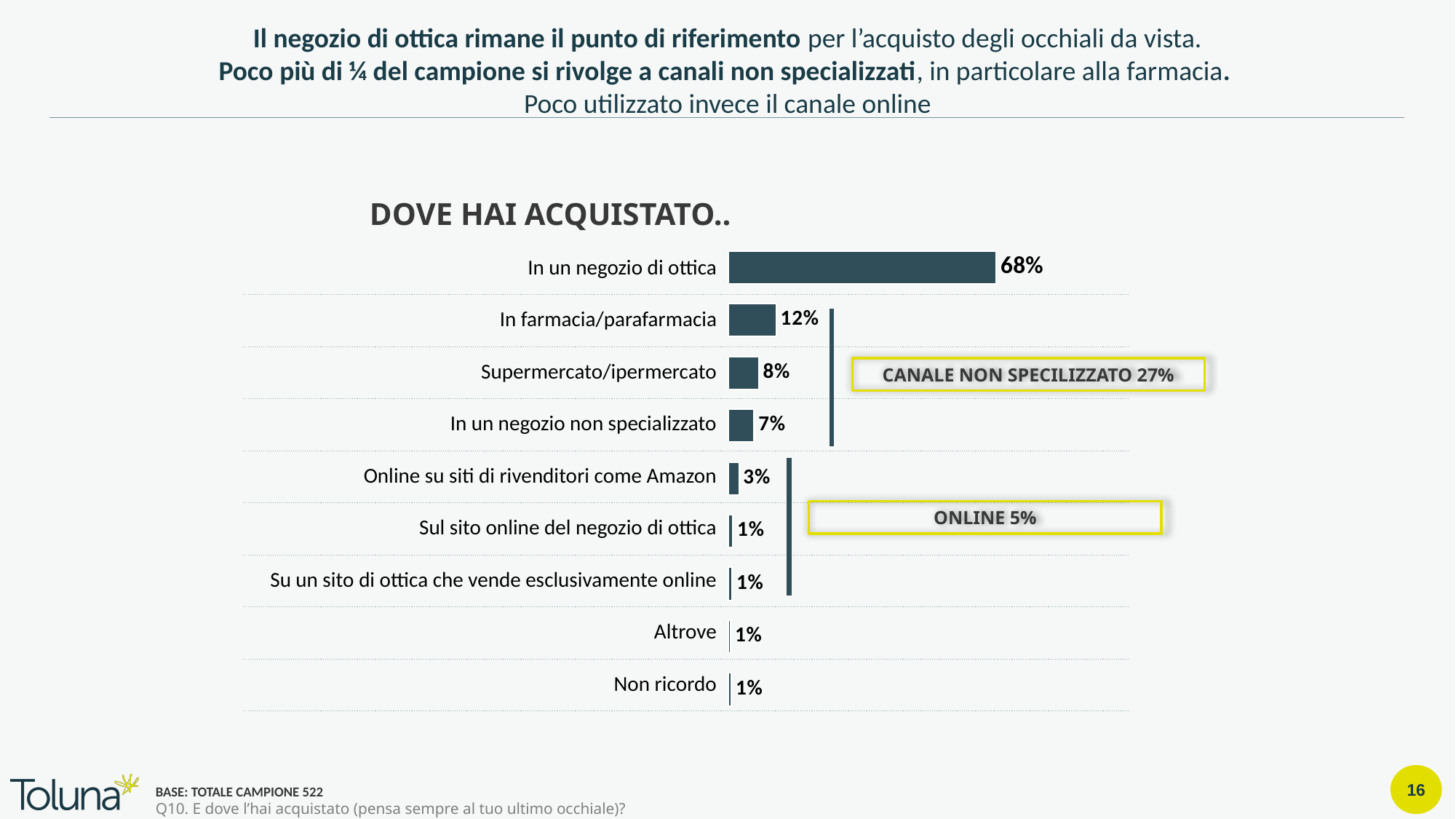
What is the value for "Online su siti di rivenditori come Amazon"? 3% What is the title of the chart? DOVE HAI ACQUISTATO.. Which is larger: "In farmacia/parafarmacia" or "Supermercato/ipermercato"? In farmacia/parafarmacia What percentage is shown in the "CANALE NON SPECILIZZATO" box? 27% What is the value for "In farmacia/parafarmacia"? 12% What kind of chart is shown on the slide? Bar chart What is the difference between "In un negozio di ottica" and "In farmacia/parafarmacia"? 56% What is the difference between "Supermercato/ipermercato" and "In un negozio non specializzato"? 1% Which category has the highest value? In un negozio di ottica What is the value for "In un negozio di ottica"? 68% How many categories are shown in the chart? 9 What is the value for "Supermercato/ipermercato"? 8%